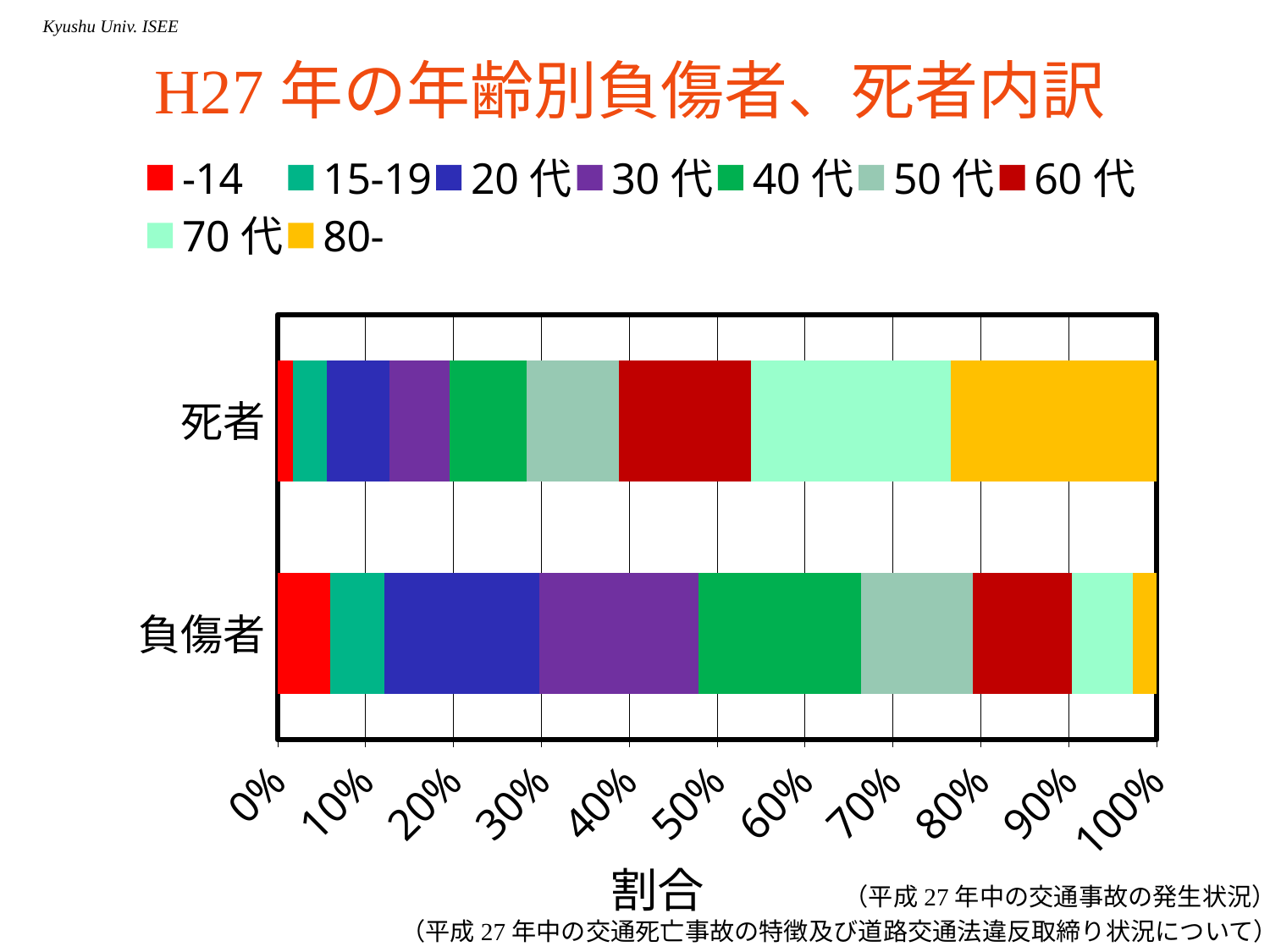
Is the share of the -14 segment in the 死者 bar greater or less than 10%? less Is the share of the 80- segment in the 死者 bar greater or less than 20%? greater Is the share of the 80- segment in the 負傷者 bar greater or less than 10%? less What is the title of the chart on the slide? H27年の年齢別負傷者、死者内訳 What is the label of the horizontal axis? 割合 How many series does the legend list? 9 Which bar has the larger 80- segment, 死者 or 負傷者? 死者 Which age group has the smallest segment in the 負傷者 bar? 80- What kind of chart is shown on the slide? stacked bar chart Which bar has the larger 20代 segment, 死者 or 負傷者? 負傷者 How many categories (bars) are plotted on the chart? 2